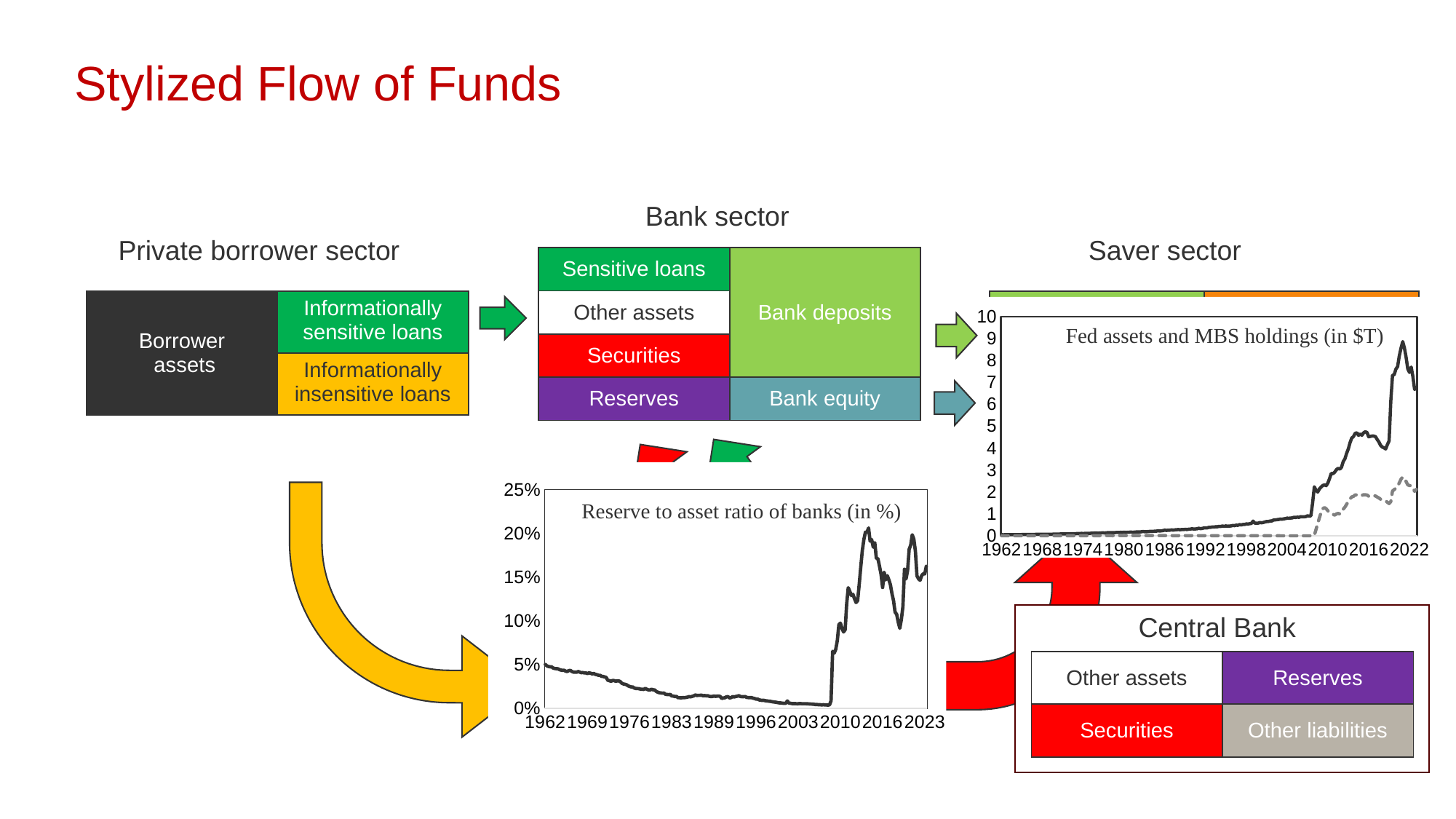
In the 'Fed assets and MBS holdings (in $T)' chart, is the solid line's value in 2004 greater or less than 2? less In the 'Fed assets and MBS holdings (in $T)' chart, does the solid line rise or fall overall between 2008 and 2022? rise What is the highest value shown on the y axis of the 'Reserve to asset ratio of banks (in %)' chart? 25% In the 'Reserve to asset ratio of banks (in %)' chart, does the ratio rise or fall between 1962 and 2003? fall What is the first year shown on the x axis of the 'Fed assets and MBS holdings (in $T)' chart? 1962 In the 'Reserve to asset ratio of banks (in %)' chart, is the value around 2003 greater or less than 5%? less In the 'Reserve to asset ratio of banks (in %)' chart, is the peak value reached after 2010 greater or less than 15%? greater What kind of chart is the 'Fed assets and MBS holdings (in $T)' chart? line chart What kind of chart is the 'Reserve to asset ratio of banks (in %)' chart? line chart In the 'Fed assets and MBS holdings (in $T)' chart, which line is higher in 2022, the solid line or the dashed line? the solid line